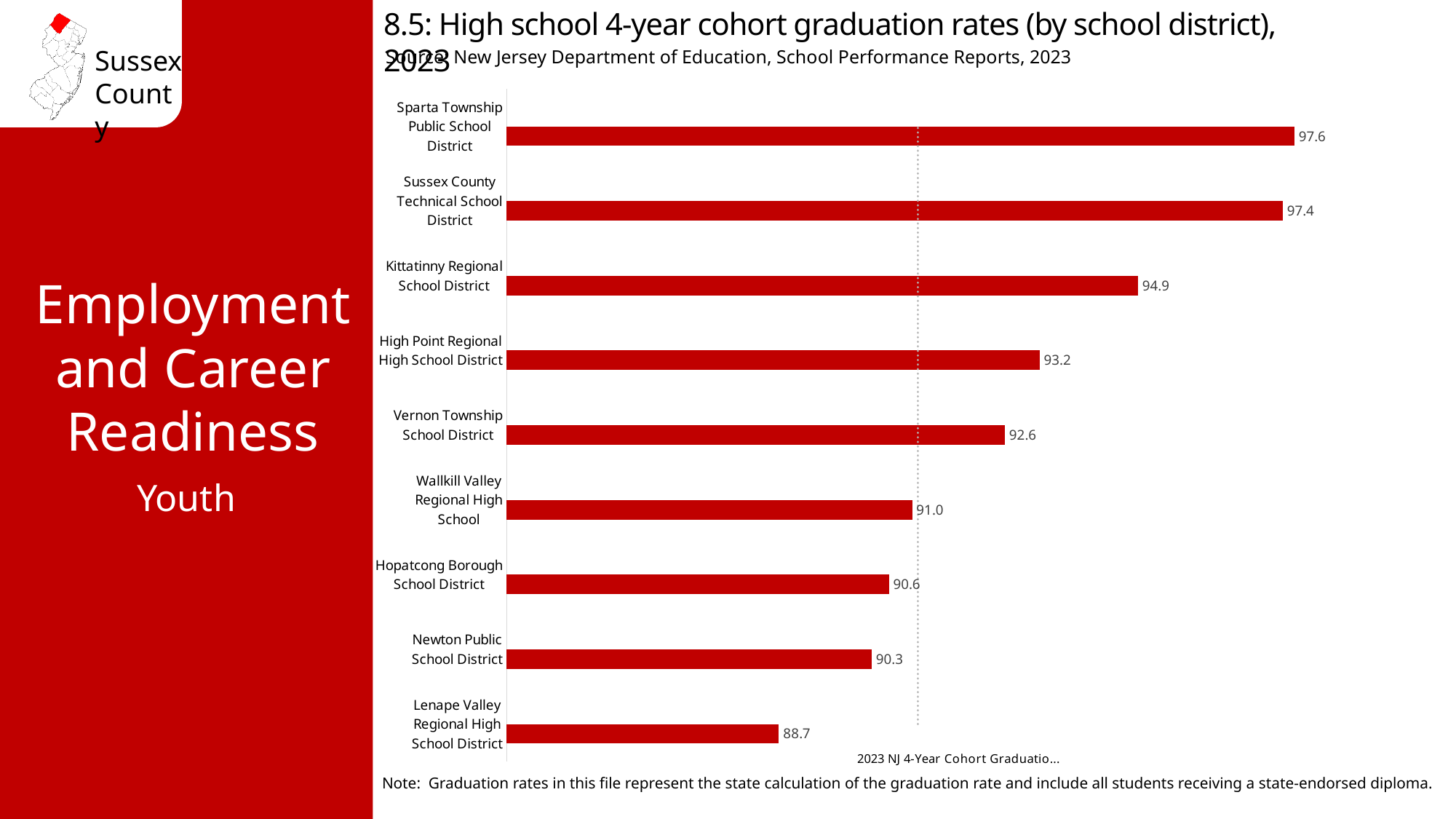
What is the source cited for the chart data? New Jersey Department of Education, School Performance Reports, 2023 What kind of chart is shown on the slide? Bar chart What is the difference between the graduation rates of Sparta Township Public School District and Lenape Valley Regional High School District? 8.9 How many school districts are shown in the chart? 9 Which school district has the lowest graduation rate? Lenape Valley Regional High School District Which has a higher graduation rate, Kittatinny Regional School District or Newton Public School District? Kittatinny Regional School District What is the graduation rate for Kittatinny Regional School District? 94.9 What is the difference between the graduation rates of High Point Regional High School District and Vernon Township School District? 0.6 What is the graduation rate for Hopatcong Borough School District? 90.6 What is the graduation rate for Lenape Valley Regional High School District? 88.7 Which school district has the highest graduation rate? Sparta Township Public School District What is the graduation rate for Sparta Township Public School District? 97.6